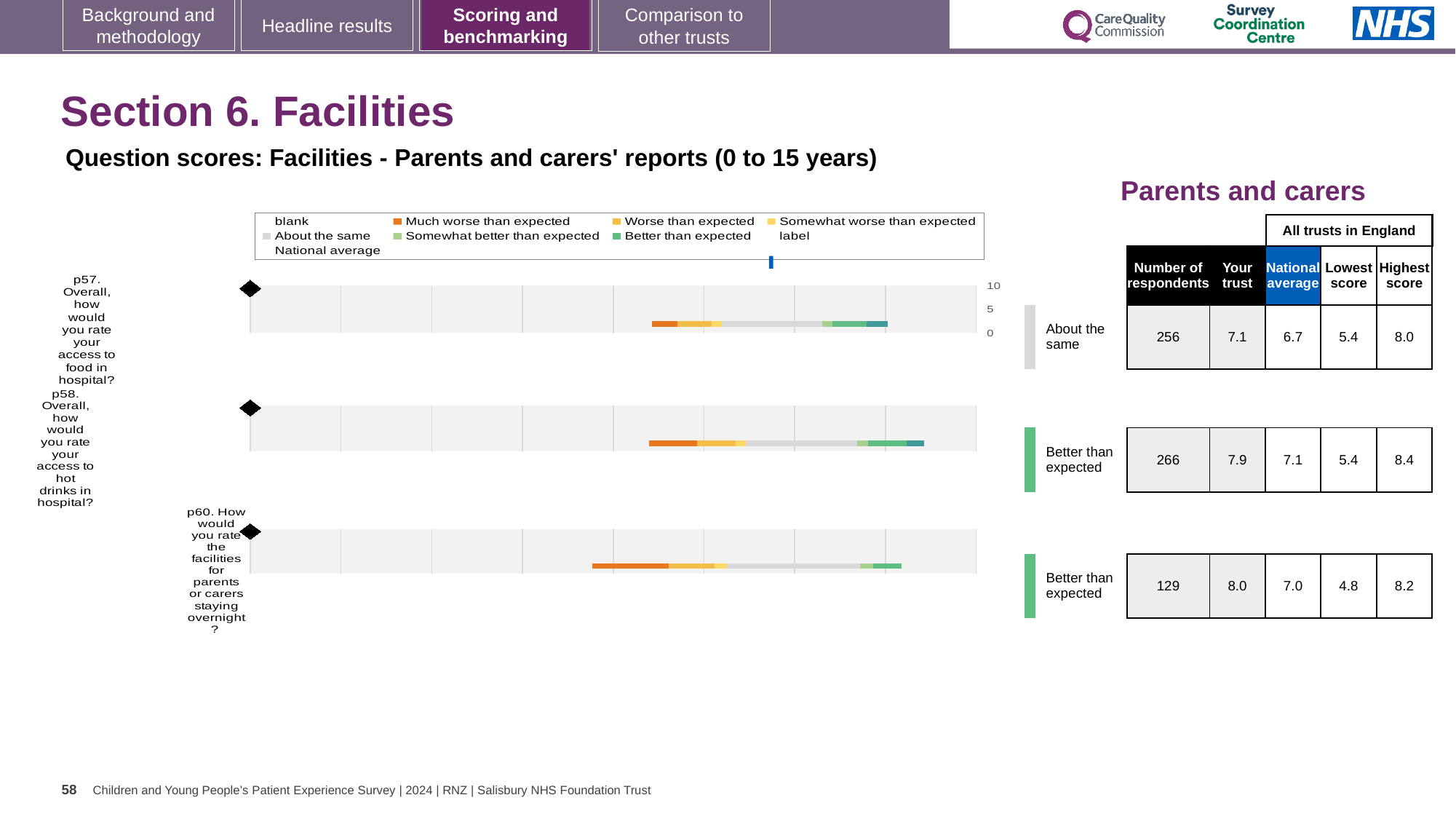
What is the national average score for p58 (access to hot drinks in hospital)? 7.1 What colour does the legend use for 'Better than expected'? Green For p60, what is the difference between the 'Your trust' score and the national average? 1.0 What is the highest score among all trusts in England for p58? 8.4 How many respondents answered p60 (facilities for parents or carers staying overnight)? 129 Which question has the highest 'Your trust' score? p60 What kind of chart is used to show the question scores for Facilities? Bar chart What is the 'Your trust' score for p57 (access to food in hospital)? 7.1 For p58, which is larger: the 'Your trust' score or the national average? Your trust How many questions (categories) are plotted in the Facilities question scores chart? 3 What benchmark category is shown for p57 (access to food in hospital)? About the same Which question has the lowest 'Your trust' score? p57